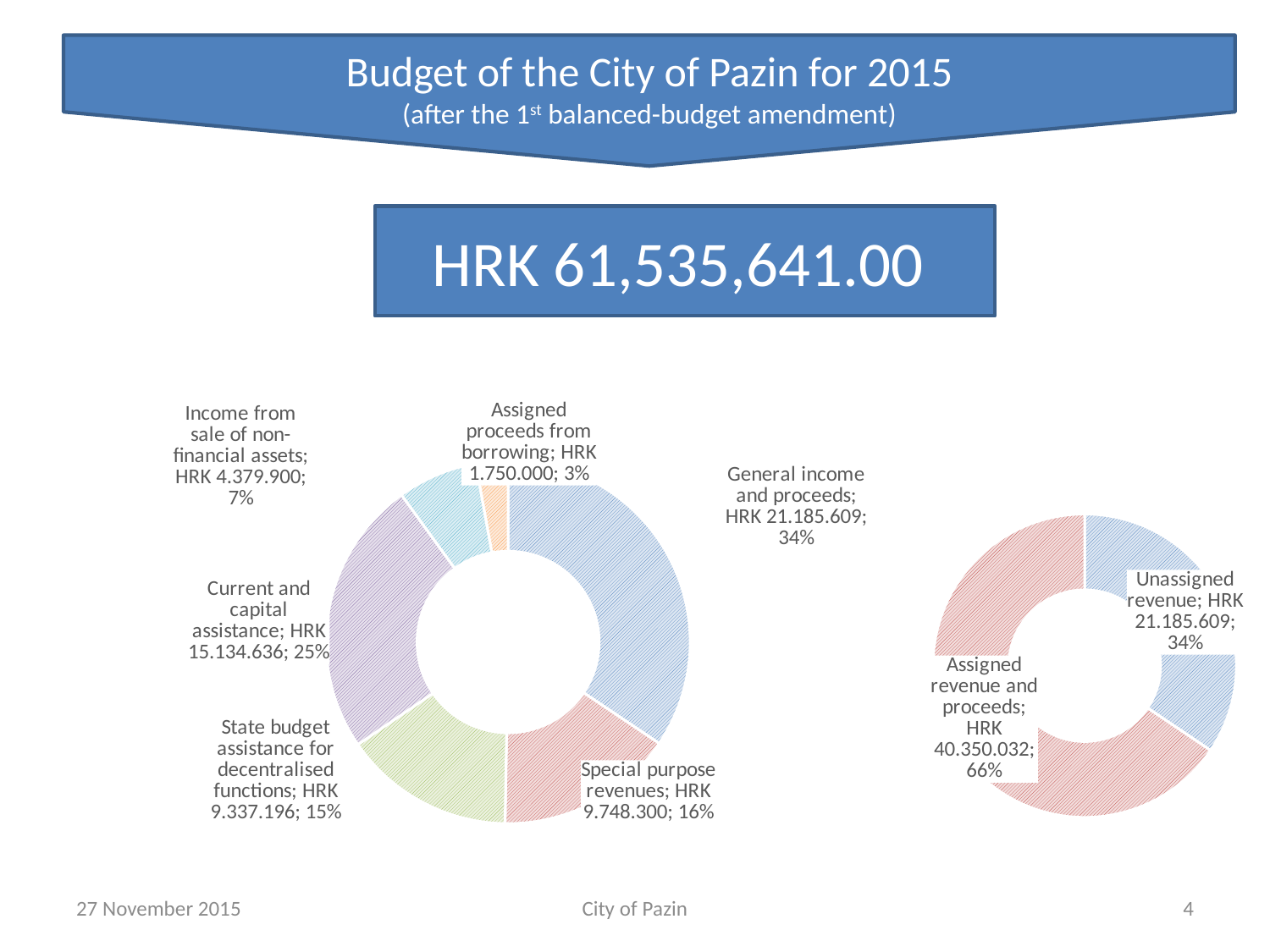
In the right chart, what percentage share does Unassigned revenue have? 34% In the left chart, what is the value for Assigned proceeds from borrowing? HRK 1.750.000 In the left chart, which category has the smallest share? Assigned proceeds from borrowing In the right chart, what is the value for Assigned revenue and proceeds? HRK 40.350.032 In the left chart, what is the difference in percentage share between Current and capital assistance and State budget assistance for decentralised functions? 10% In the left chart, what is the value for General income and proceeds? HRK 21.185.609 What type of chart is the left chart on the slide? Doughnut chart In the left chart, which is larger: Special purpose revenues or Income from sale of non-financial assets? Special purpose revenues In the left chart, which category has the largest share? General income and proceeds How many categories are shown in the left chart? 6 How many categories are shown in the right chart? 2 In the left chart, what percentage share does Current and capital assistance have? 25%